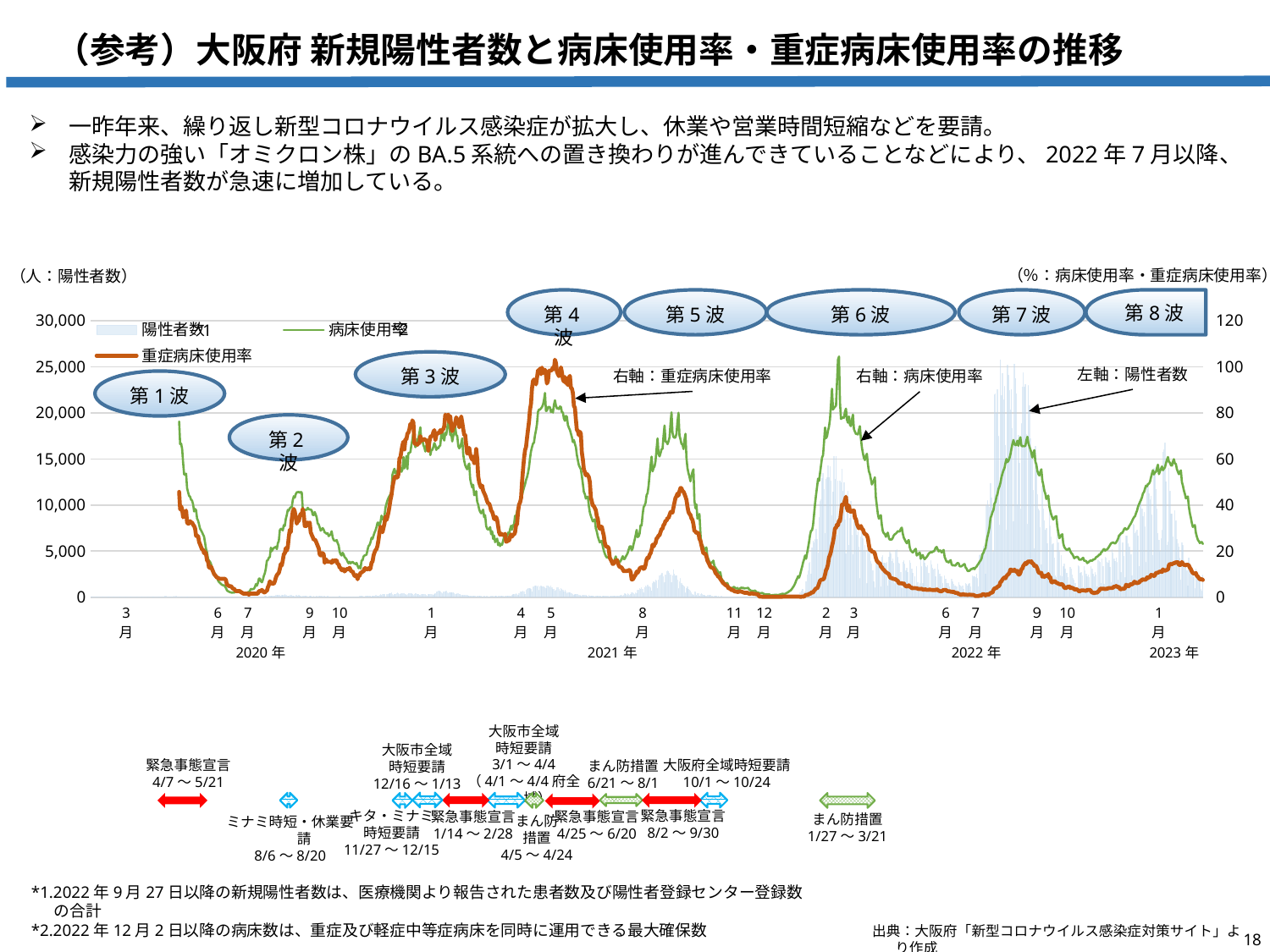
What is the highest tick value shown on the right-hand axis? 120 According to the annotation, which axis is 陽性者数 plotted on? 左軸 Which wave has the higher peak 重症病床使用率, 第4波 or 第5波? 第4波 After the 第8波 peak in 2023年1月, does 病床使用率 rise or fall toward the end of the chart? fall Is the peak value of 病床使用率 during 第6波 greater or less than 80? greater Which wave has the higher peak 陽性者数, 第6波 or 第7波? 第7波 Is the peak number of 陽性者数 during 第7波 greater or less than 20,000? greater Is the peak value of 重症病床使用率 during 第7波 greater or less than 20? less How many series does the chart legend list? 3 How many waves (第1波 to 第8波) are labelled on the chart? 8 What kind of chart is used to show 病床使用率 and 重症病床使用率? line chart